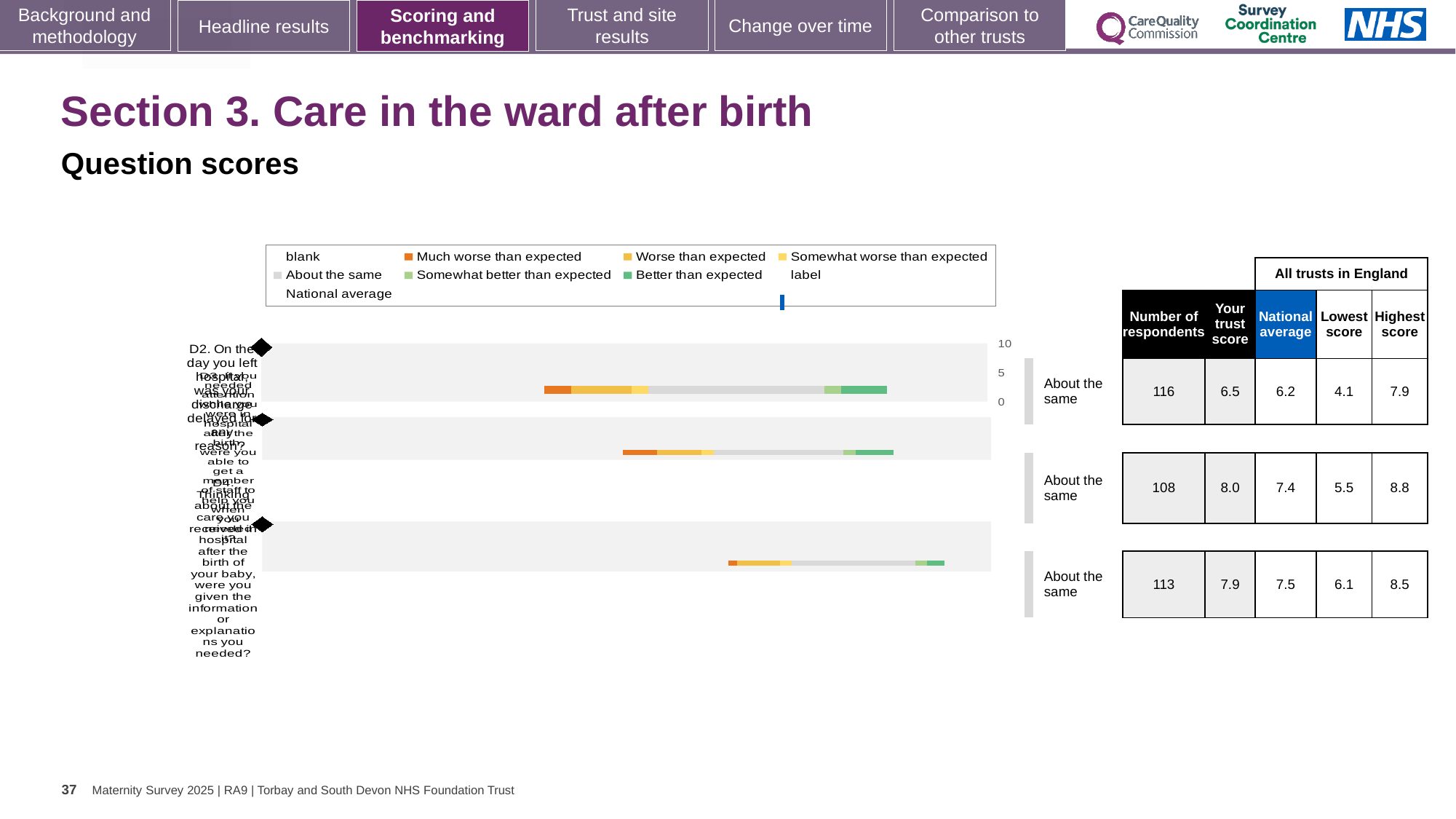
What is the difference between the trust score and the national average for the first (top) question? 0.3 Which question has the highest 'Your trust score'? the second (middle) question What is the highest score across all trusts in England for the second (middle) question? 8.8 How many question bars are plotted in the chart? 3 What is the 'Your trust score' for the first (top) question? 6.5 What is the lowest score across all trusts in England for the third (bottom) question? 6.1 What kind of chart is shown on the slide? bar chart What benchmark category is shown next to each of the three bars? About the same What is the national average for the second (middle) question? 7.4 In the table beside the chart, what is the number of respondents for the first (top) question? 116 Which question has the lowest number of respondents? the second (middle) question Is the trust score for the third (bottom) question larger or smaller than its national average? larger